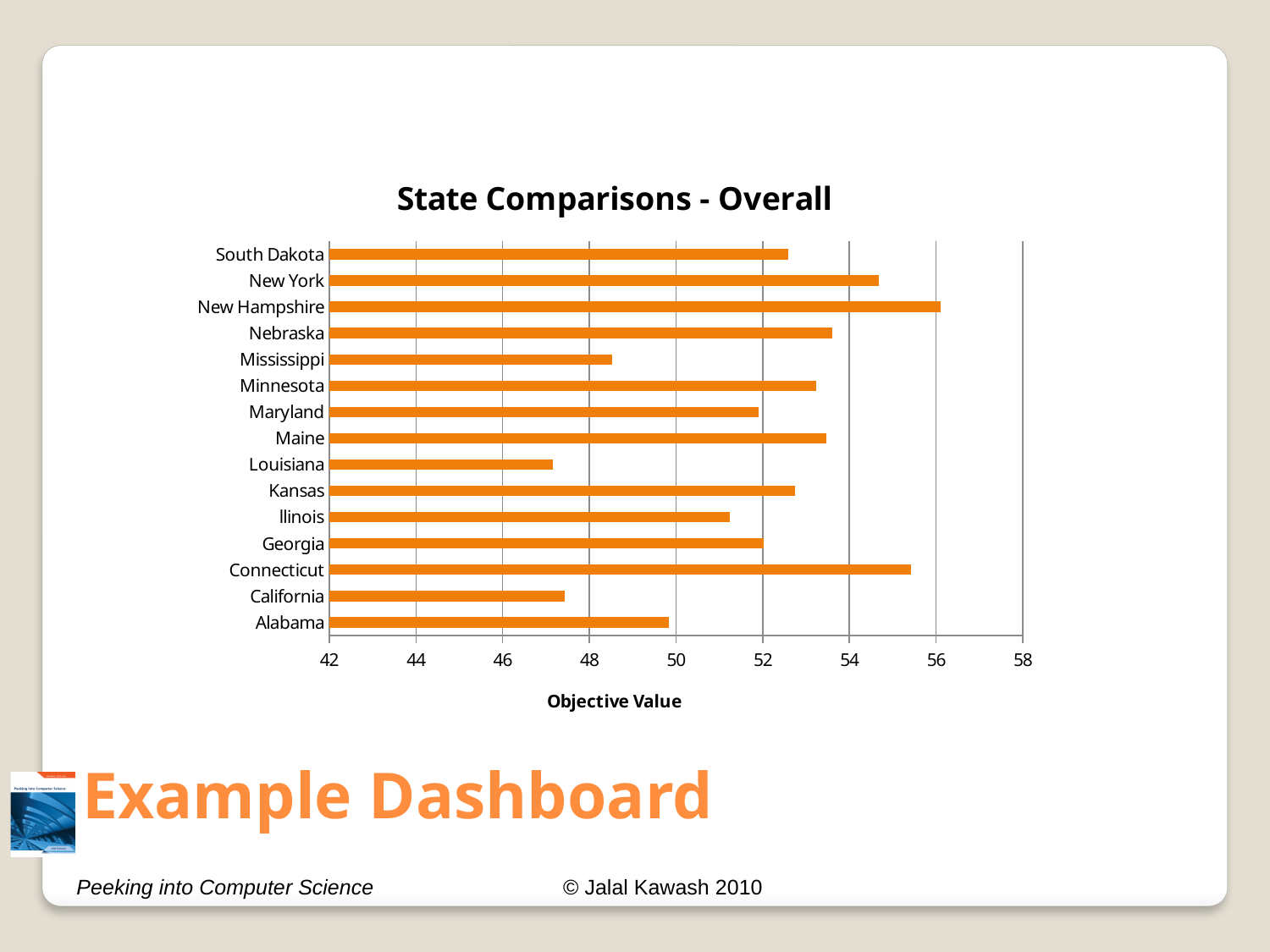
Is the value for Mississippi greater or less than 50? less What is the label on the horizontal axis of the chart? Objective Value How many states are shown in the chart? 15 Which has a lower objective value, Mississippi or Alabama? Mississippi Is the value for New York greater or less than 54? greater What kind of chart is shown on the slide? Bar chart Is the value for Nebraska greater or less than 52? greater Which state has the highest objective value? New Hampshire Which has a higher objective value, New York or Nebraska? New York Which has a higher objective value, Connecticut or South Dakota? Connecticut What is the title of the chart? State Comparisons - Overall